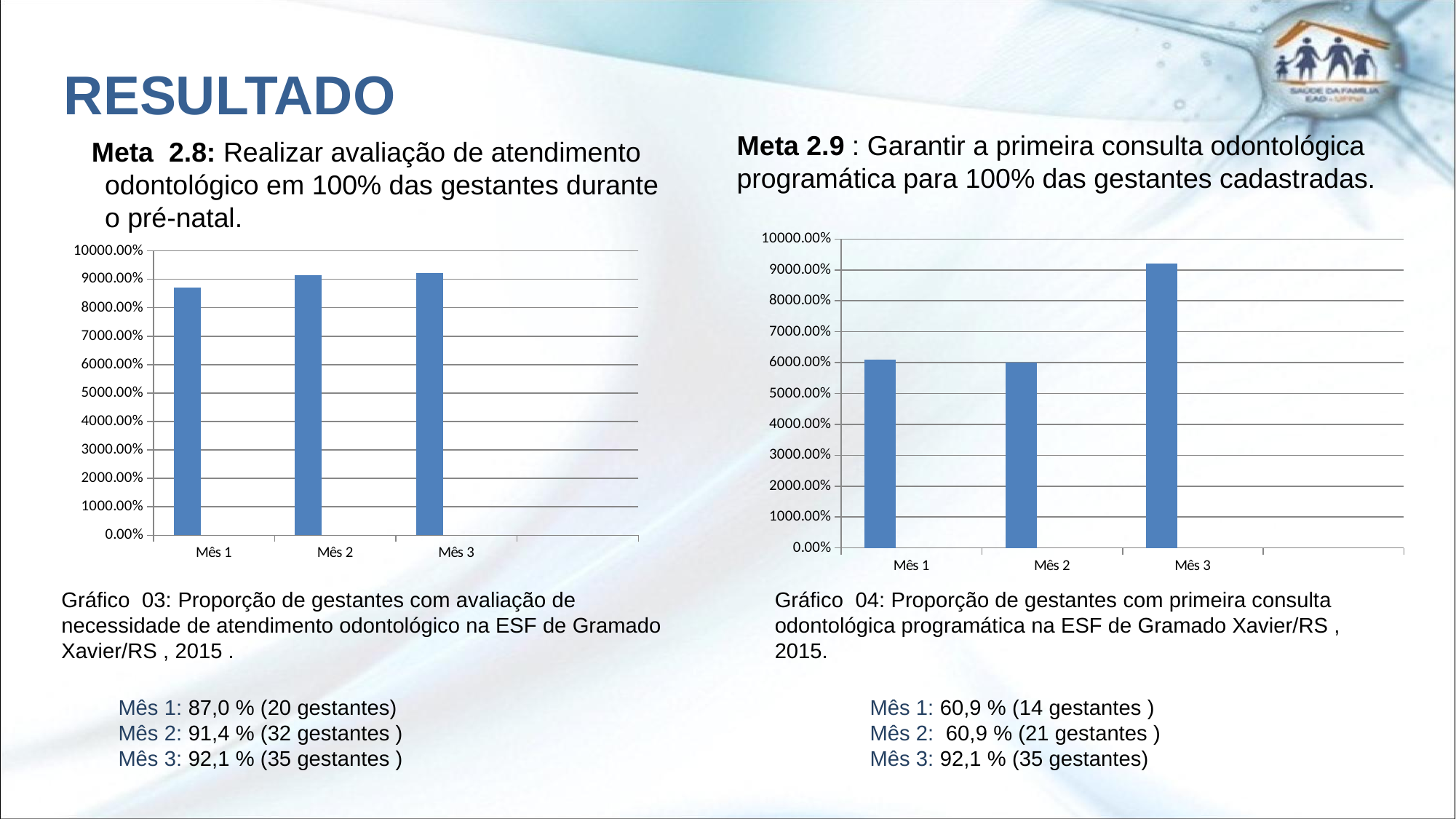
In Gráfico 04 on the right, is the value for Mês 3 greater or less than 9000.00%? greater In Gráfico 03 on the left, is the value for Mês 2 greater or less than 9000.00%? greater What kind of chart is Gráfico 03 on the left of the slide? bar chart In Gráfico 04 on the right, which is larger, the bar for Mês 2 or the bar for Mês 3? Mês 3 In Gráfico 03 on the left, which is larger, the bar for Mês 1 or the bar for Mês 2? Mês 2 In Gráfico 04 on the right, which month has the highest bar? Mês 3 In Gráfico 03 on the left, is the value for Mês 1 greater or less than 9000.00%? less In Gráfico 03 on the left, which month has the lowest bar? Mês 1 What is the label of the first category on the x axis of Gráfico 03 on the left? Mês 1 In Gráfico 03 on the left, do the bars rise or fall from Mês 1 to Mês 3? rise How many categories are shown on the x axis of Gráfico 04 on the right of the slide? 3